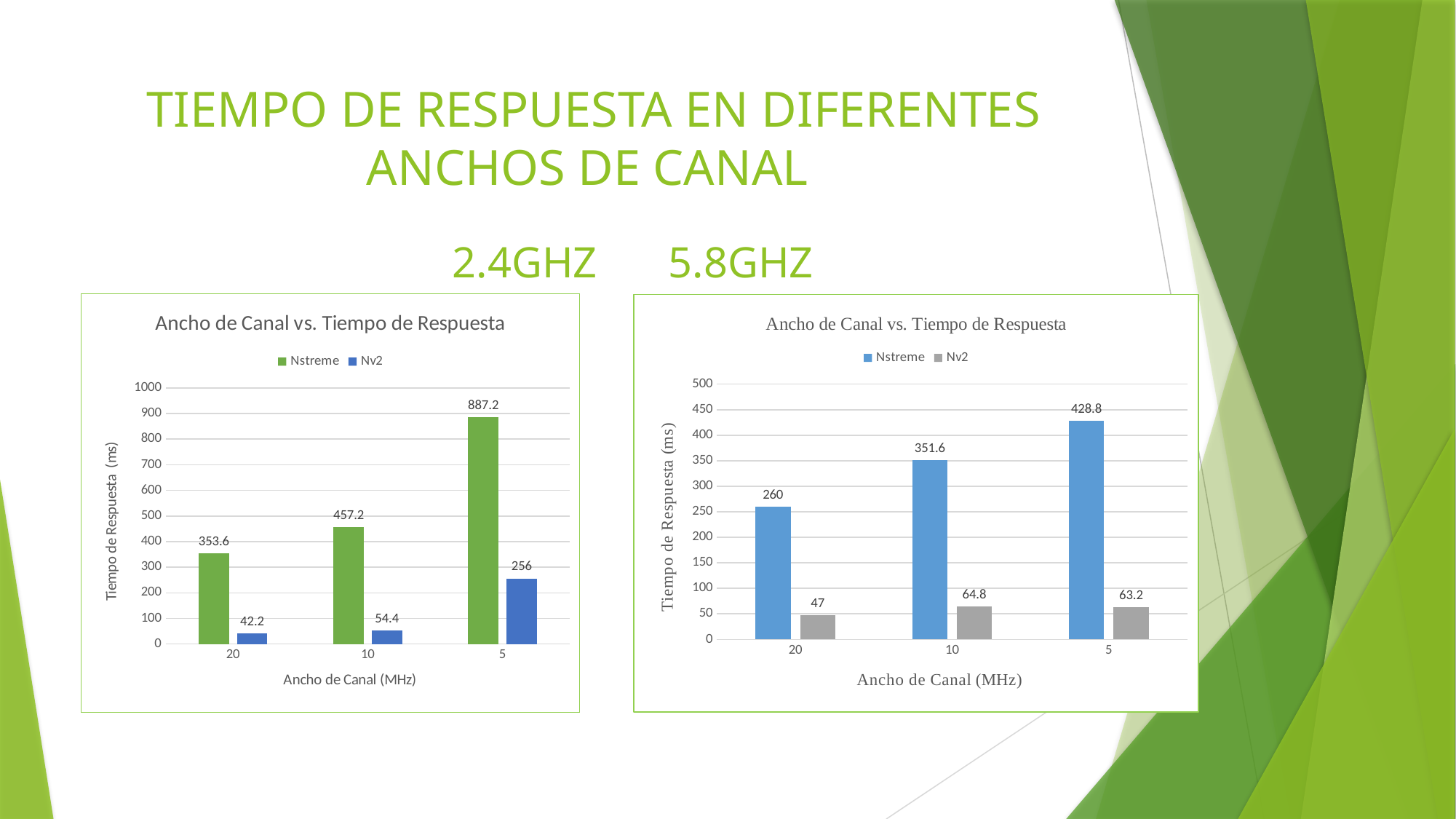
In the right (5.8GHz) chart, which channel width has the lowest Nv2 response time? 20 How many channel width categories are shown on the x axis of the left (2.4GHz) chart? 3 In the left (2.4GHz) chart, what is the Nstreme response time at 20 MHz channel width? 353.6 What type of chart is the right (5.8GHz) chart? Bar chart In the left (2.4GHz) chart, which channel width has the highest Nstreme response time? 5 In the right (5.8GHz) chart, what is the difference between the Nstreme values at 5 MHz and 20 MHz? 168.8 In the right (5.8GHz) chart, what is the Nv2 response time at 10 MHz channel width? 64.8 In the right (5.8GHz) chart, which is larger at 10 MHz: Nstreme or Nv2? Nstreme In the left (2.4GHz) chart, is the Nstreme value at 10 MHz greater or less than 400? greater How many series does the legend of the right (5.8GHz) chart list? 2 In the left (2.4GHz) chart, do the Nstreme values rise or fall moving left to right along the x axis? Rise In the left (2.4GHz) chart, what is the difference between the Nstreme and Nv2 response times at 5 MHz? 631.2